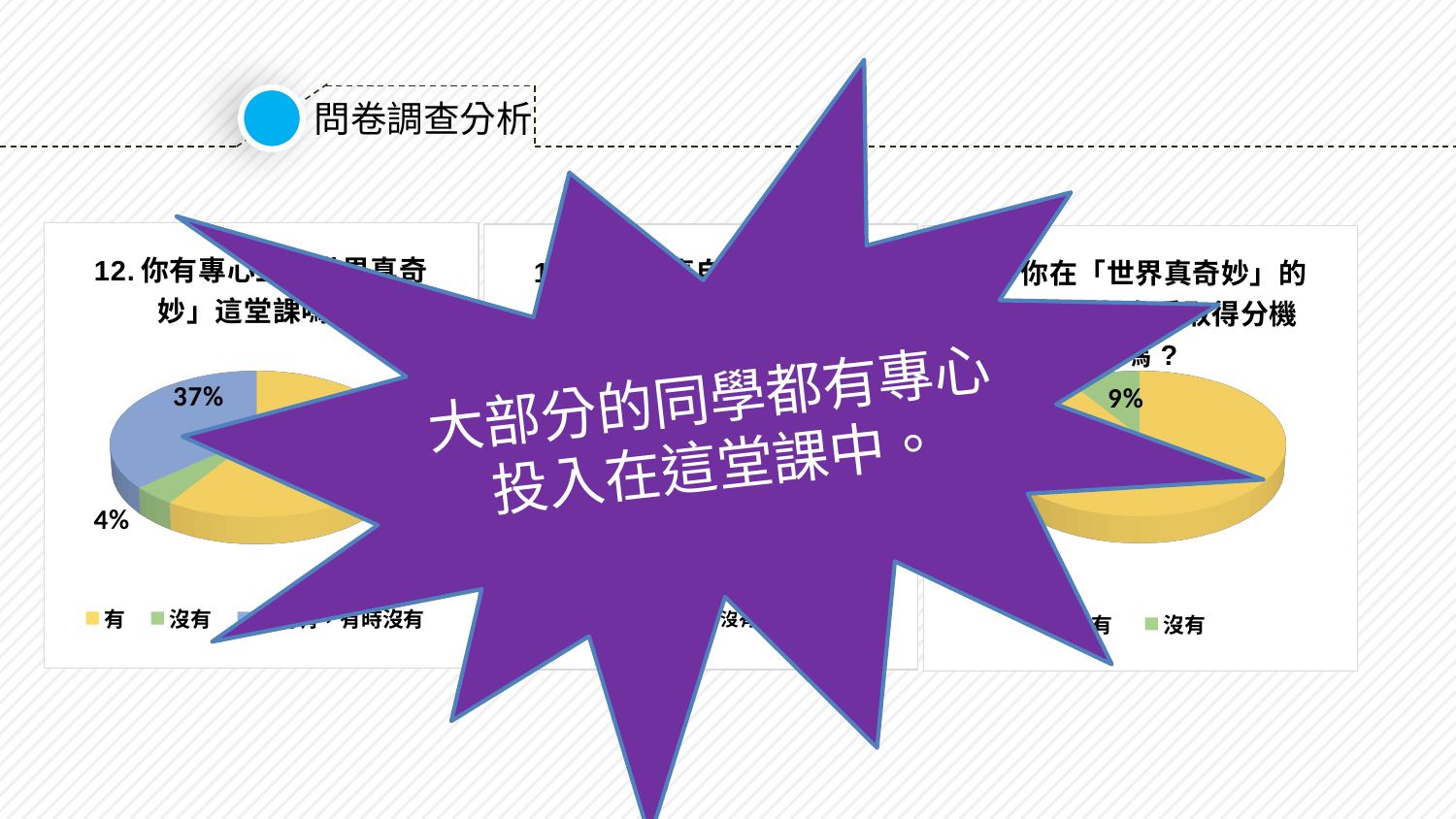
In the rightmost pie chart, which category has the smallest slice? 沒有 In the leftmost pie chart, which is larger: the blue slice or the 沒有 (green) slice? the blue slice In the leftmost pie chart, what is the difference between the blue slice (37%) and the 沒有 slice (4%)? 33% How many entries does the legend of the rightmost pie chart list? 2 In the leftmost pie chart, what percentage is shown for the 沒有 (green) slice? 4% In the rightmost pie chart, what percentage is shown for the 沒有 (green) slice? 9% How many charts are shown on the slide? 3 In the rightmost pie chart, which slice is larger: 有 (yellow) or 沒有 (green)? 有 What kind of chart is the leftmost chart on the slide? pie chart In the leftmost pie chart, what percentage is shown for the blue slice? 37% What colour represents 有 in the legends of the pie charts? yellow What is the section heading shown at the top of the slide? 問卷調查分析